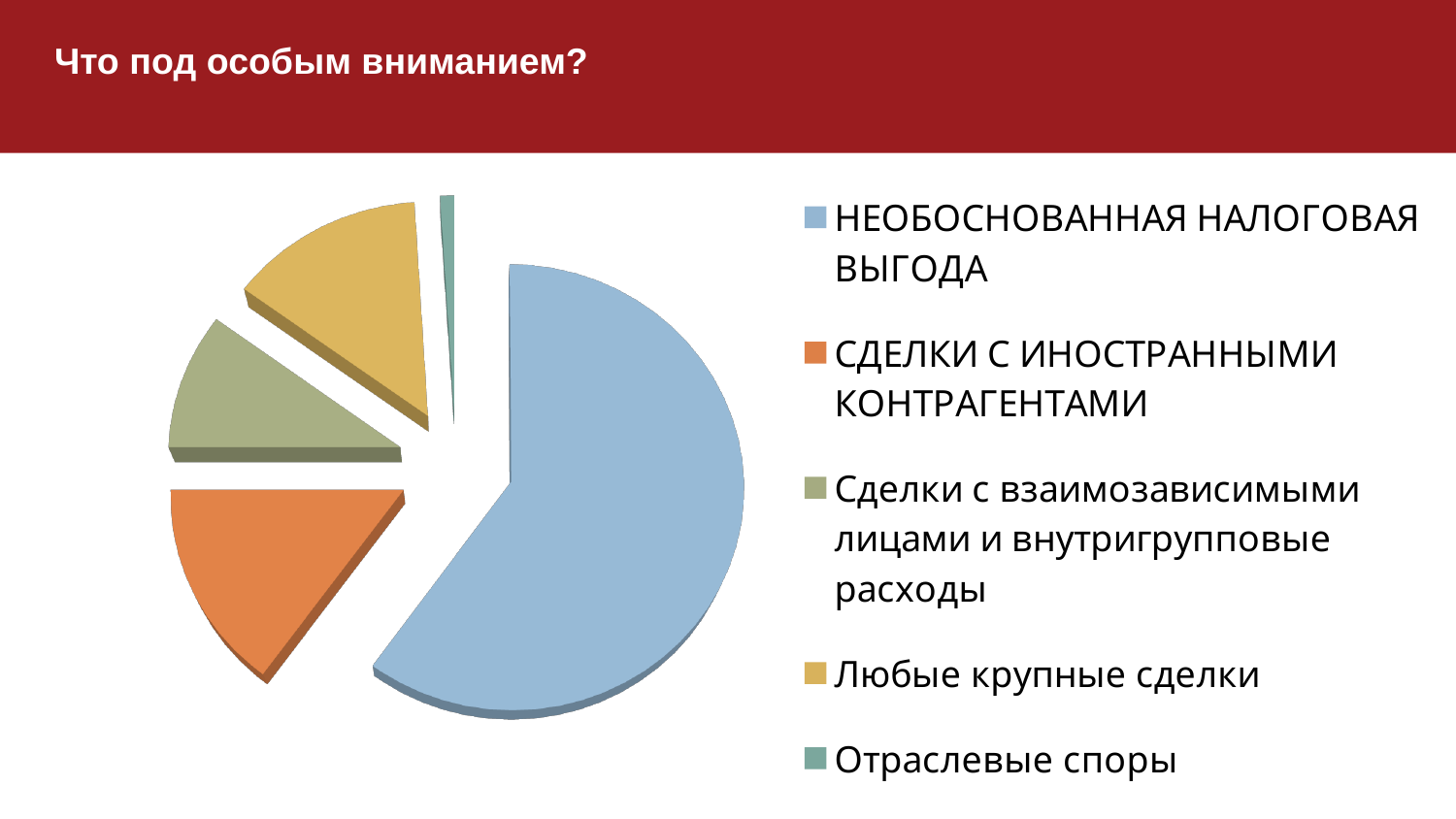
Which slice is larger: Любые крупные сделки or Отраслевые споры? Любые крупные сделки How many slices does the pie chart have? 5 Which slice is larger: Сделки с взаимозависимыми лицами и внутригрупповые расходы or Отраслевые споры? Сделки с взаимозависимыми лицами и внутригрупповые расходы Which slice is larger: НЕОБОСНОВАННАЯ НАЛОГОВАЯ ВЫГОДА or СДЕЛКИ С ИНОСТРАННЫМИ КОНТРАГЕНТАМИ? НЕОБОСНОВАННАЯ НАЛОГОВАЯ ВЫГОДА Which category has the smallest slice in the pie chart? Отраслевые споры What colour is the slice for СДЕЛКИ С ИНОСТРАННЫМИ КОНТРАГЕНТАМИ? orange What kind of chart is shown on the slide? pie chart Which category has the largest slice in the pie chart? НЕОБОСНОВАННАЯ НАЛОГОВАЯ ВЫГОДА How many entries does the legend of the pie chart list? 5 Which category is shown in light blue in the pie chart? НЕОБОСНОВАННАЯ НАЛОГОВАЯ ВЫГОДА